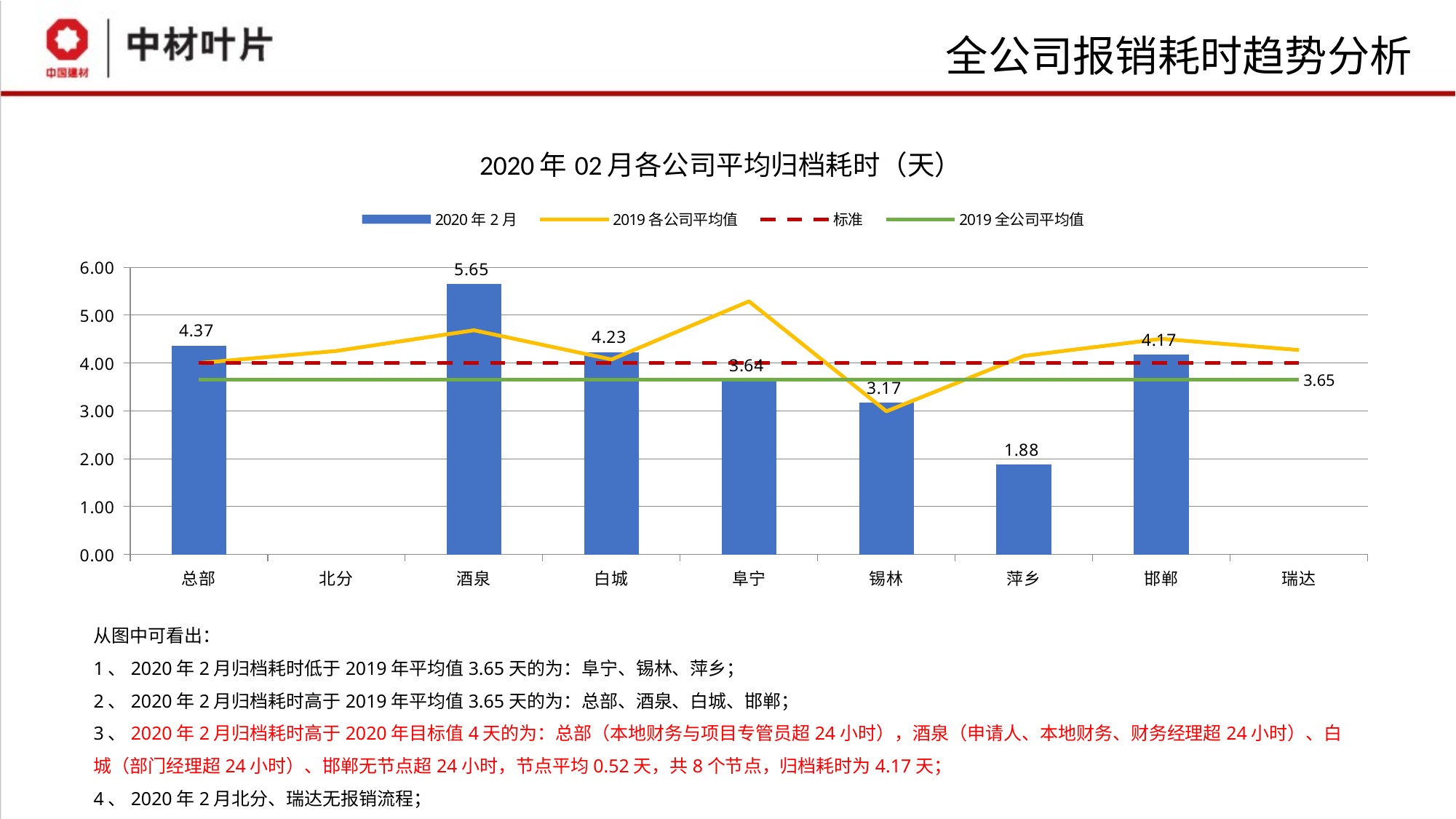
What is the 2020年2月 value for 酒泉? 5.65 What is the 2020年2月 value for 萍乡? 1.88 Which company has the highest 2020年2月 bar? 酒泉 What value is labelled on the green 2019全公司平均值 line? 3.65 What is the 2020年2月 value for 邯郸? 4.17 What is the title of the chart? 2020年02月各公司平均归档耗时（天） How many series does the legend list? 4 Is the 2020年2月 value for 锡林 greater or less than 4.00? less How many categories are shown on the x axis? 9 Which is larger, the 2020年2月 value for 白城 or for 邯郸? 白城 Among the companies with a bar shown, which has the lowest 2020年2月 value? 萍乡 What is the difference between the 2020年2月 values for 酒泉 and 总部? 1.28